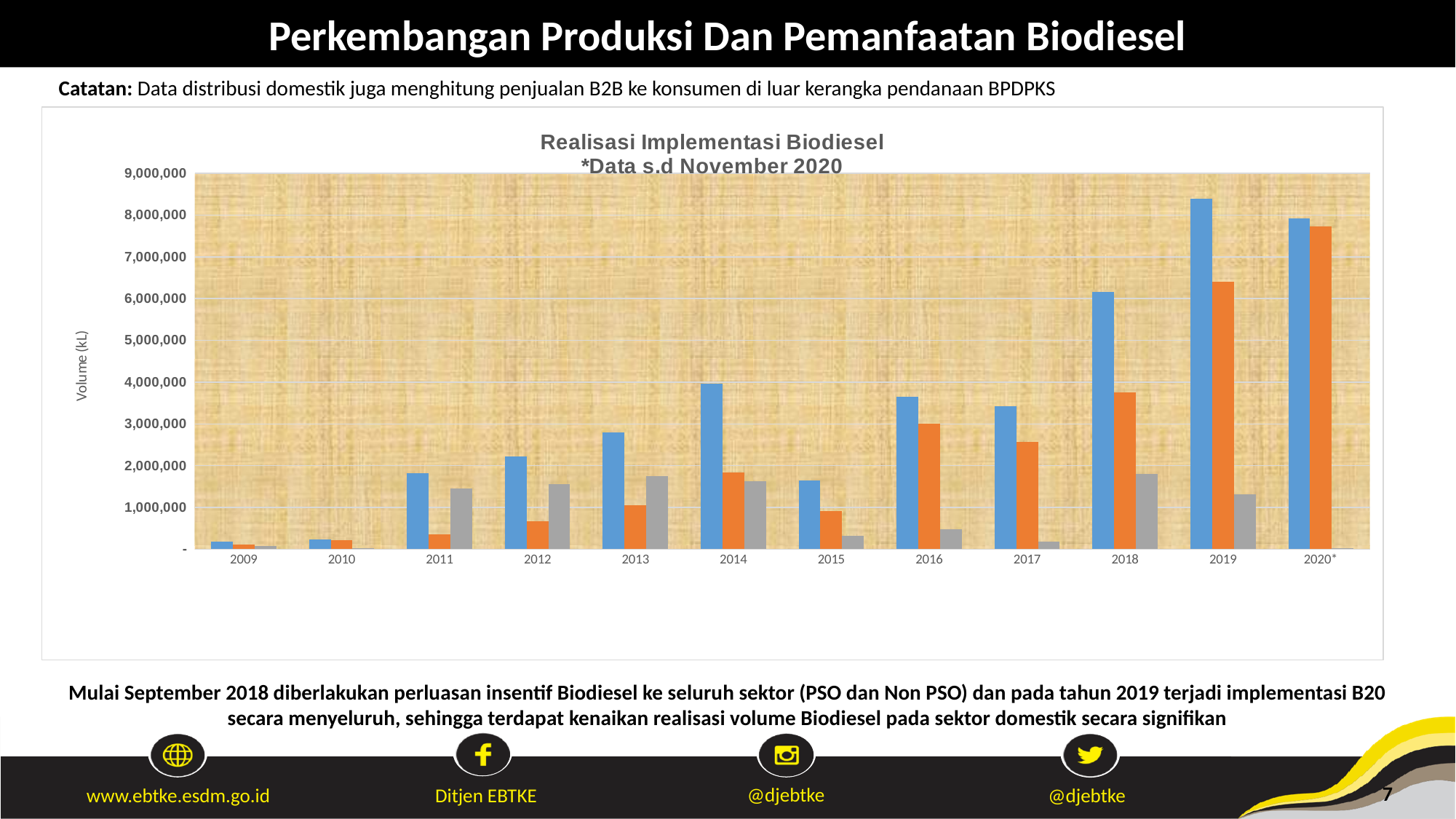
Is the value of the blue bar for 2015 greater or less than 2,000,000? less In which year is the blue bar the shortest? 2009 What is the label of the vertical axis? Volume (kL) Is the value of the blue bar for 2019 greater or less than 8,000,000? greater What is the title of the chart? Realisasi Implementasi Biodiesel *Data s.d November 2020 Do the blue bars rise or fall from 2017 to 2019? rise In which year is the blue bar the tallest? 2019 In which year is the orange bar the tallest? 2020* How many years are shown on the x axis of the chart? 12 Is the value of the orange bar for 2019 greater or less than 6,000,000? greater In 2011, which is larger: the orange bar or the gray bar? the gray bar What kind of chart is shown on the slide? bar chart